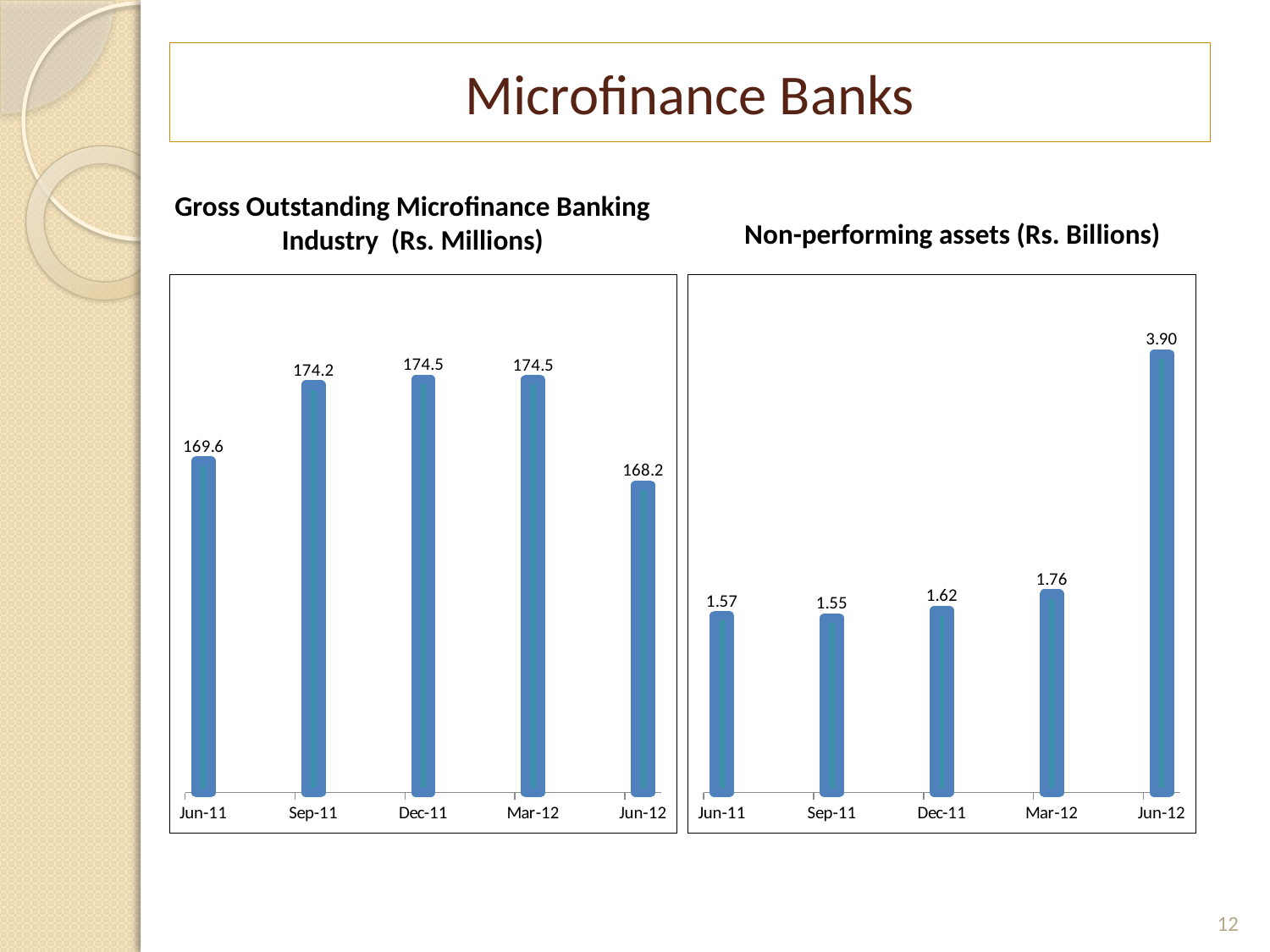
In the Gross Outstanding Microfinance Banking Industry chart, what is the value for Jun-11? 169.6 In the Non-performing assets chart, what is the difference between the Jun-12 and Mar-12 values? 2.14 In the Gross Outstanding Microfinance Banking Industry chart, which period has the lowest value? Jun-12 In the Non-performing assets chart, which is larger, the value for Dec-11 or the value for Jun-11? Dec-11 In the Non-performing assets chart, which period has the lowest value? Sep-11 In the Gross Outstanding Microfinance Banking Industry chart, what is the value for Jun-12? 168.2 In the Non-performing assets chart, what is the value for Mar-12? 1.76 In the Gross Outstanding Microfinance Banking Industry chart, what is the difference between the Sep-11 and Jun-11 values? 4.6 In the Non-performing assets chart, which period has the highest value? Jun-12 In the Non-performing assets chart, what is the value for Jun-12? 3.90 In the Gross Outstanding Microfinance Banking Industry chart, how many periods are shown on the x axis? 5 What kind of chart is the Non-performing assets chart? Bar chart